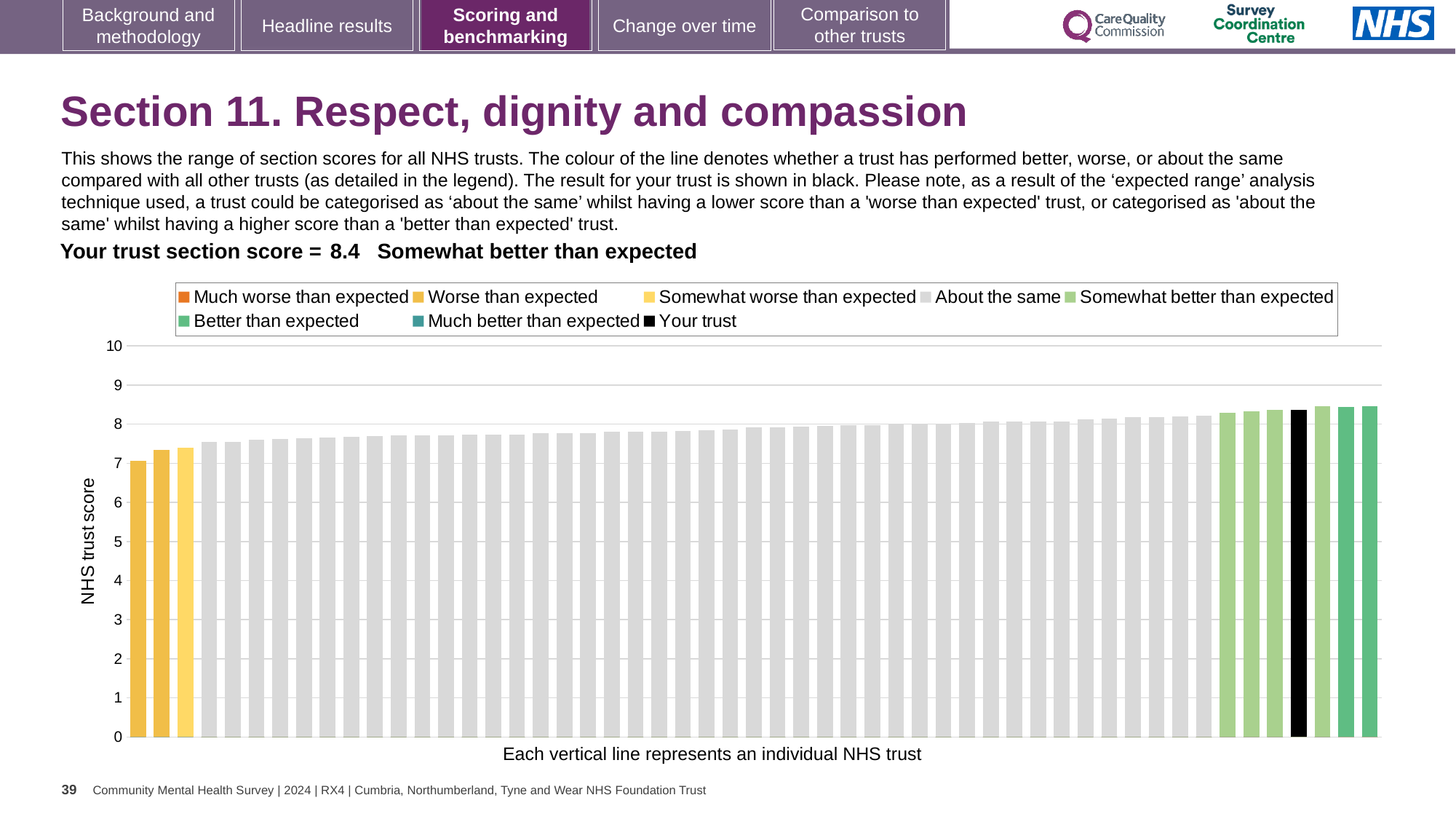
What is the section score for your trust shown on the slide? 8.4 Is the value for your trust greater or less than 9? less Which is larger, the leftmost bar or the rightmost bar? the rightmost bar What kind of chart is shown on the slide? bar chart Do the bar values rise or fall from left to right along the x axis? rise How many entries does the chart legend list? 8 How is your trust's score categorised compared with other trusts? Somewhat better than expected Is the value of the leftmost bar greater or less than 8? less What is the title of the vertical axis? NHS trust score Is the value for your trust greater or less than 8? greater What colour is the bar representing your trust? black